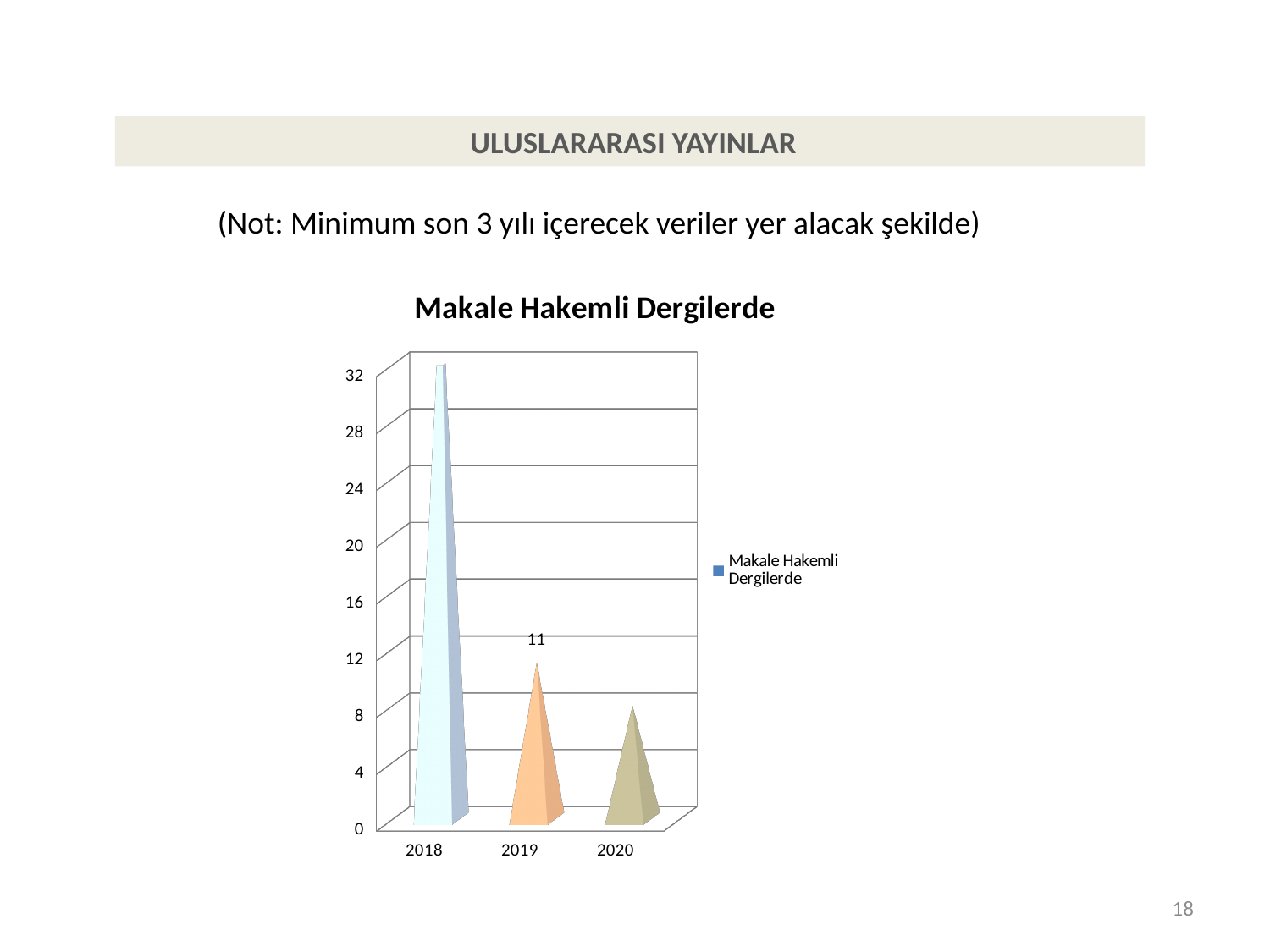
Which is larger, the value for 2019 or the value for 2020? 2019 How many series does the legend list? 1 Is the value for 2018 greater or less than 20? greater How many years are shown on the x axis of the chart? 3 What kind of chart is shown on the slide? bar chart Which year has the lowest value in the chart? 2020 Which is larger, the value for 2018 or the value for 2020? 2018 What is the value for 2019 in the Makale Hakemli Dergilerde chart? 11 Do the values rise or fall from 2018 to 2020? fall Is the value for 2020 greater or less than 12? less What is the title of the chart? Makale Hakemli Dergilerde Which year has the highest value in the chart? 2018